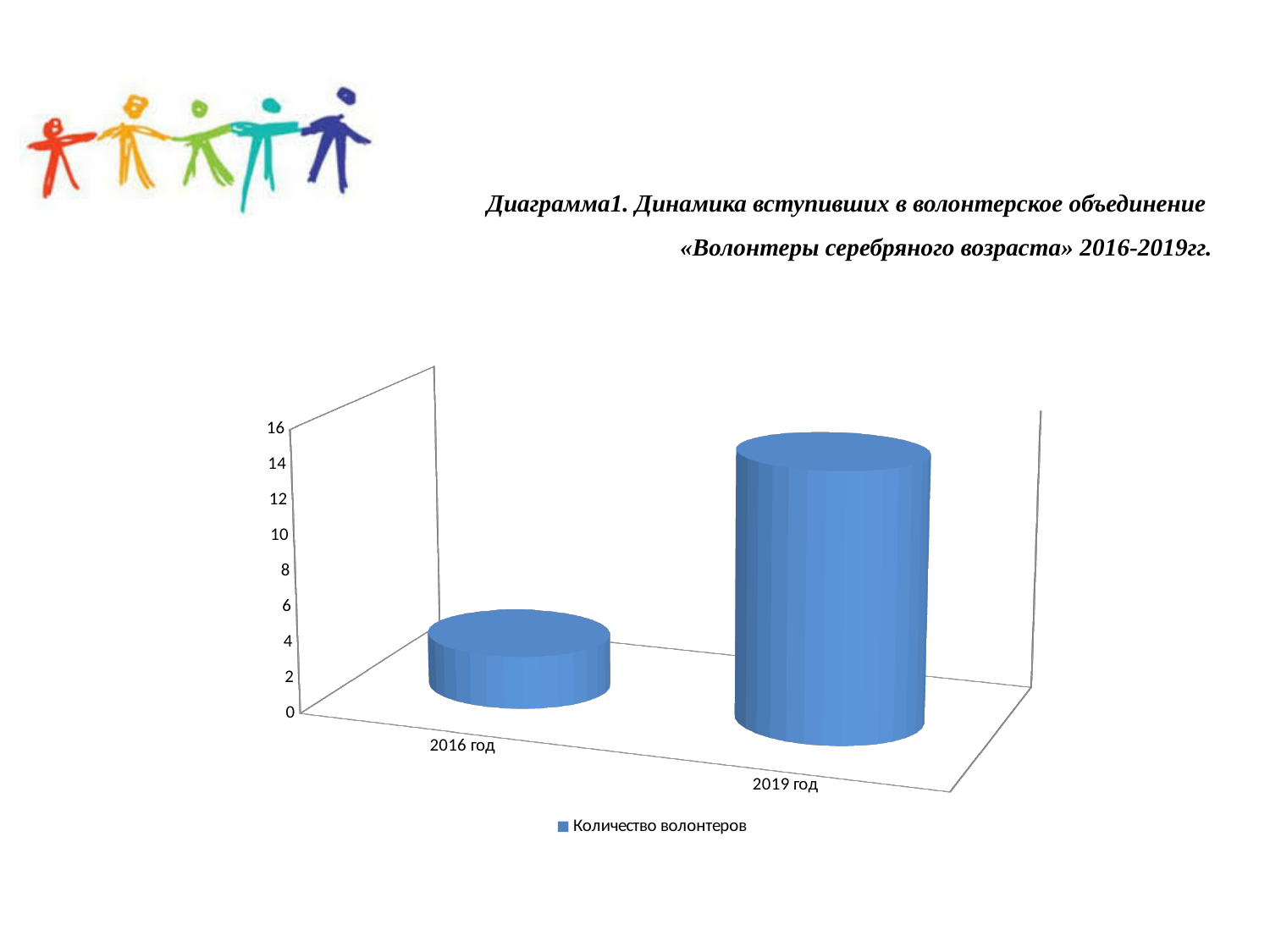
What kind of chart is shown on the slide? bar chart How many series does the chart legend list? 1 Which category has the lowest value in the chart? 2016 год Do the values rise or fall from 2016 год to 2019 год? rise What is the highest tick value shown on the vertical axis of the chart? 16 Is the value for 2019 год greater or less than 10? greater Which category has the highest value in the chart? 2019 год How many categories are shown on the x axis of the chart? 2 Is the value for 2016 год greater or less than 8? less Which is larger, the value for 2016 год or the value for 2019 год? 2019 год What is the name of the series shown in the chart legend? Количество волонтеров